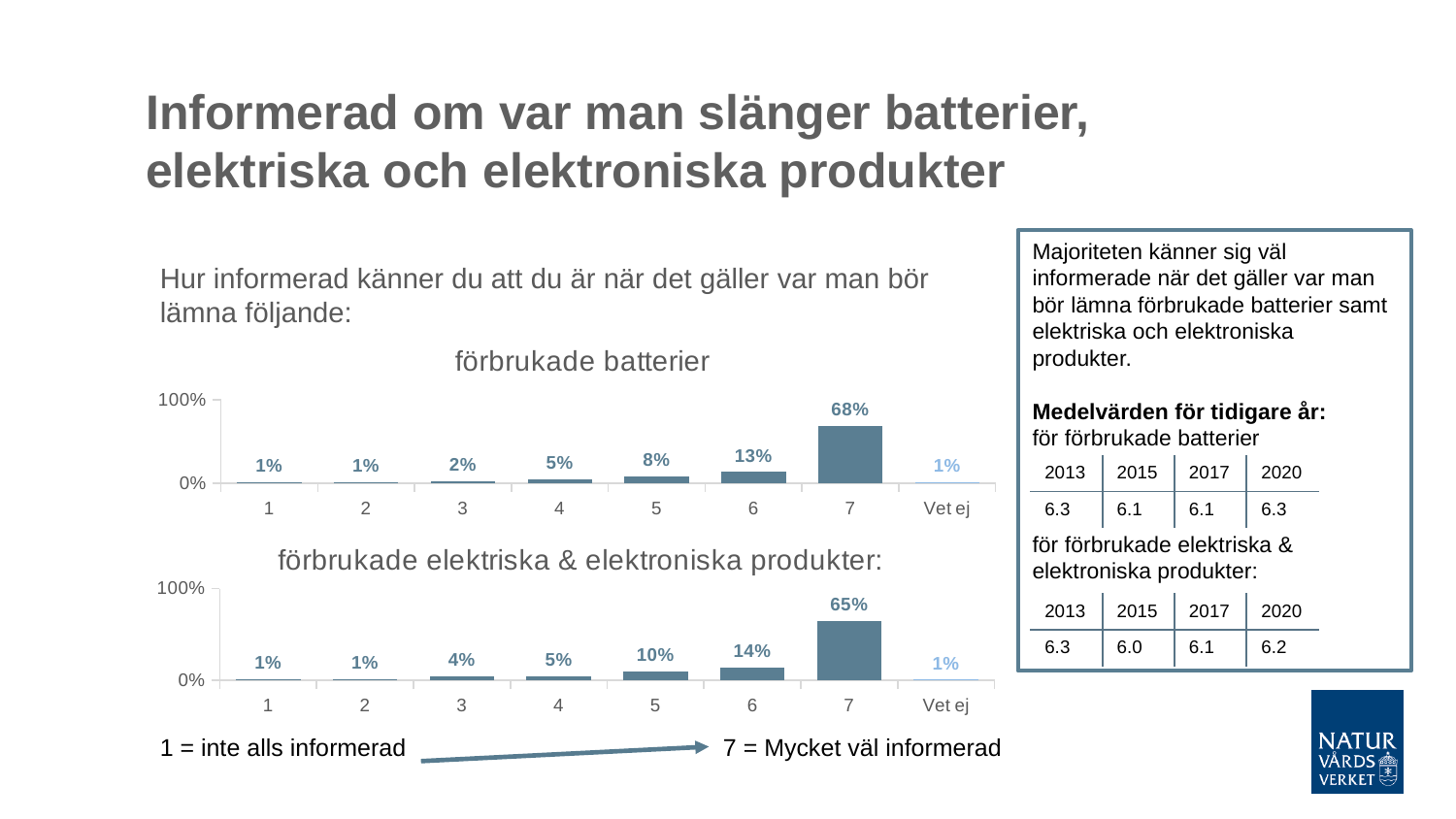
In the 'förbrukade elektriska & elektroniska produkter' chart, what is the value for category 6? 14% In the 'förbrukade batterier' chart, what is the value for category 7? 68% In the 'förbrukade batterier' chart, what is the difference between the values for category 5 and category 4? 3% In the 'förbrukade batterier' chart, which category has the highest value? 7 In the 'förbrukade batterier' chart, what is the difference between the values for category 7 and category 6? 55% In the 'förbrukade elektriska & elektroniska produkter' chart, what is the value for 'Vet ej'? 1% What is the title of the top chart? förbrukade batterier In the 'förbrukade elektriska & elektroniska produkter' chart, which is larger: the value for category 3 or category 4? Category 4 What type of chart is the 'förbrukade elektriska & elektroniska produkter' chart? Bar chart In the 'förbrukade elektriska & elektroniska produkter' chart, what is the value for category 5? 10% In the 'förbrukade batterier' chart, do the values rise or fall from category 1 to category 7? Rise How many categories are shown on the x axis of the 'förbrukade batterier' chart? 8